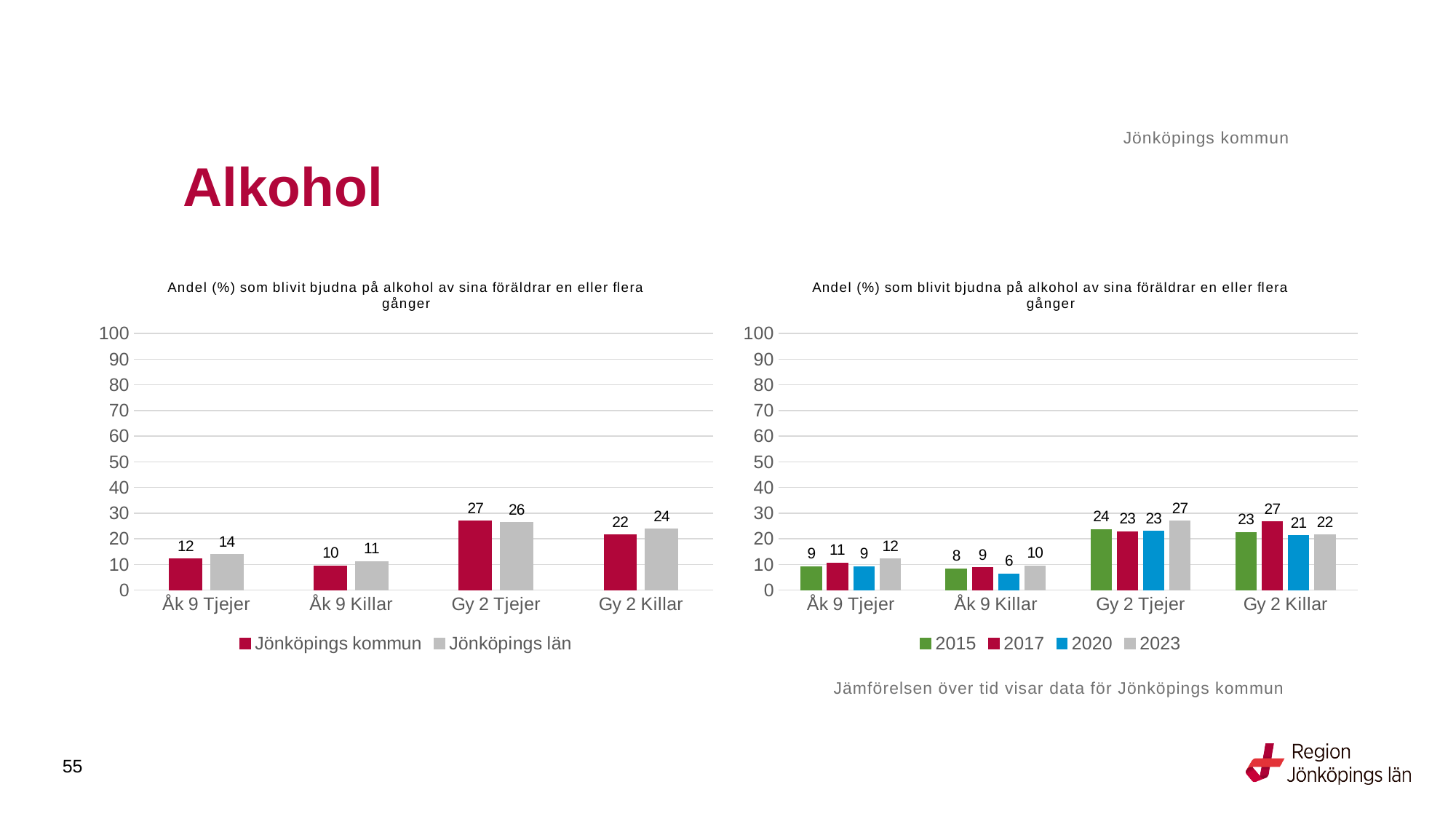
In the left chart, which category has the lowest value for Jönköpings kommun? Åk 9 Killar In the right chart, what is the difference between 2023 and 2015 for Gy 2 Tjejer? 3 How many series does the legend of the right chart list? 4 In the left chart, which is larger for Åk 9 Tjejer: Jönköpings kommun or Jönköpings län? Jönköpings län In the right chart, what is the value for 2023 for Åk 9 Killar? 10 In the left chart, what is the value for Jönköpings kommun for Gy 2 Tjejer? 27 In the left chart, what is the difference between Jönköpings län and Jönköpings kommun for Gy 2 Killar? 2 How many series does the legend of the left chart list? 2 In the left chart, what is the value for Jönköpings län for Åk 9 Killar? 11 In the right chart, what is the value for 2017 for Gy 2 Killar? 27 In the right chart, which year has the lowest value for Åk 9 Killar? 2020 What kind of chart is the right chart? Bar chart